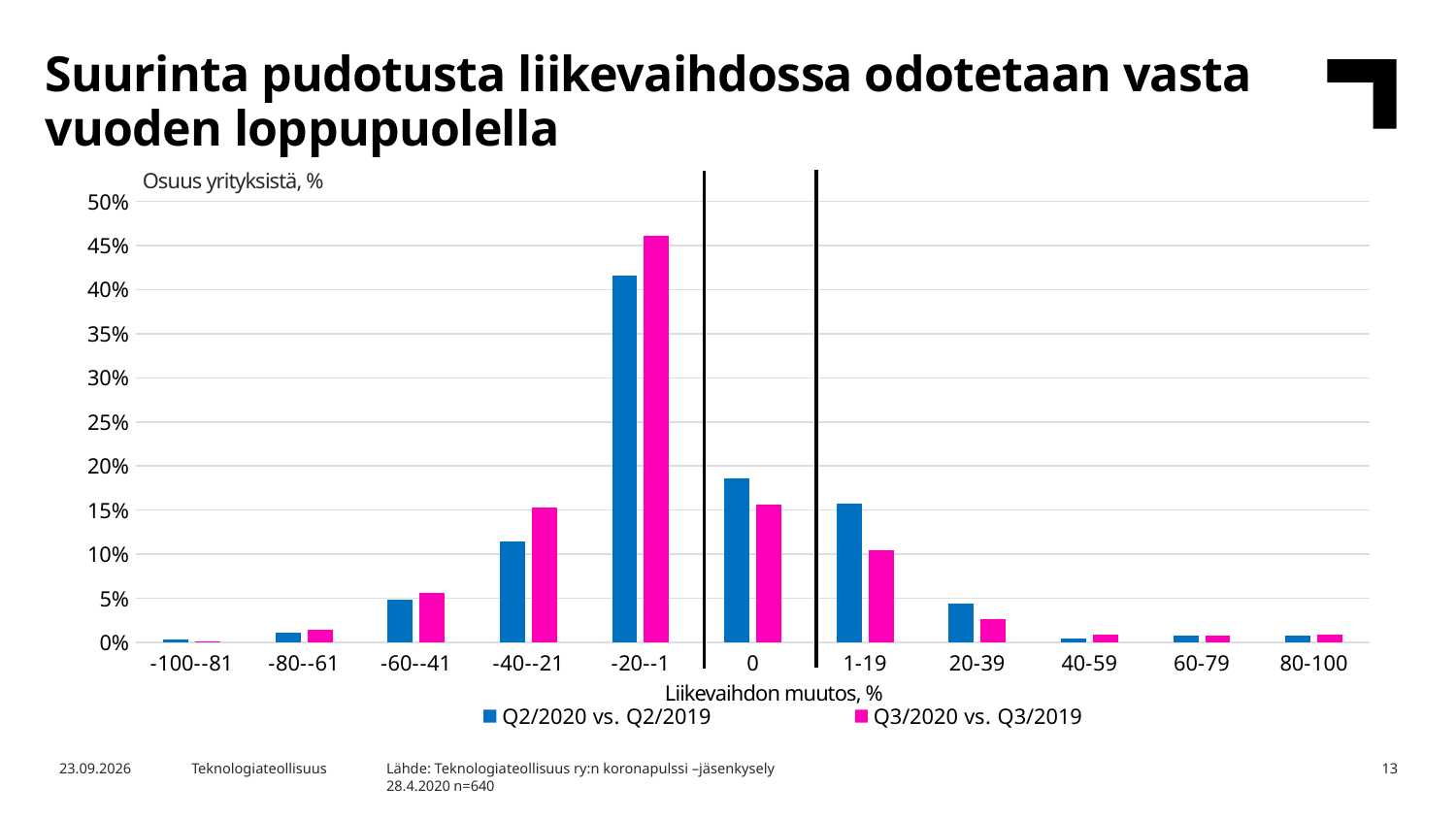
How many series does the legend list? 2 In the -40--21 category, which series has the larger value, Q2/2020 vs. Q2/2019 or Q3/2020 vs. Q3/2019? Q3/2020 vs. Q3/2019 Is the value for Q3/2020 vs. Q3/2019 in the 1-19 category greater or less than 15%? less Which category has the highest value for the Q3/2020 vs. Q3/2019 series? -20--1 What is the title of the x axis of the chart? Liikevaihdon muutos, % Which category has the lowest value for the Q3/2020 vs. Q3/2019 series? -100--81 In the 1-19 category, which series has the larger value, Q2/2020 vs. Q2/2019 or Q3/2020 vs. Q3/2019? Q2/2020 vs. Q2/2019 What type of chart is shown on the slide? bar chart How many categories are shown on the x axis? 11 Which category has the highest value for the Q2/2020 vs. Q2/2019 series? -20--1 Is the value for Q2/2020 vs. Q2/2019 in the -20--1 category greater or less than 35%? greater Is the value for Q3/2020 vs. Q3/2019 in the -20--1 category greater or less than 40%? greater